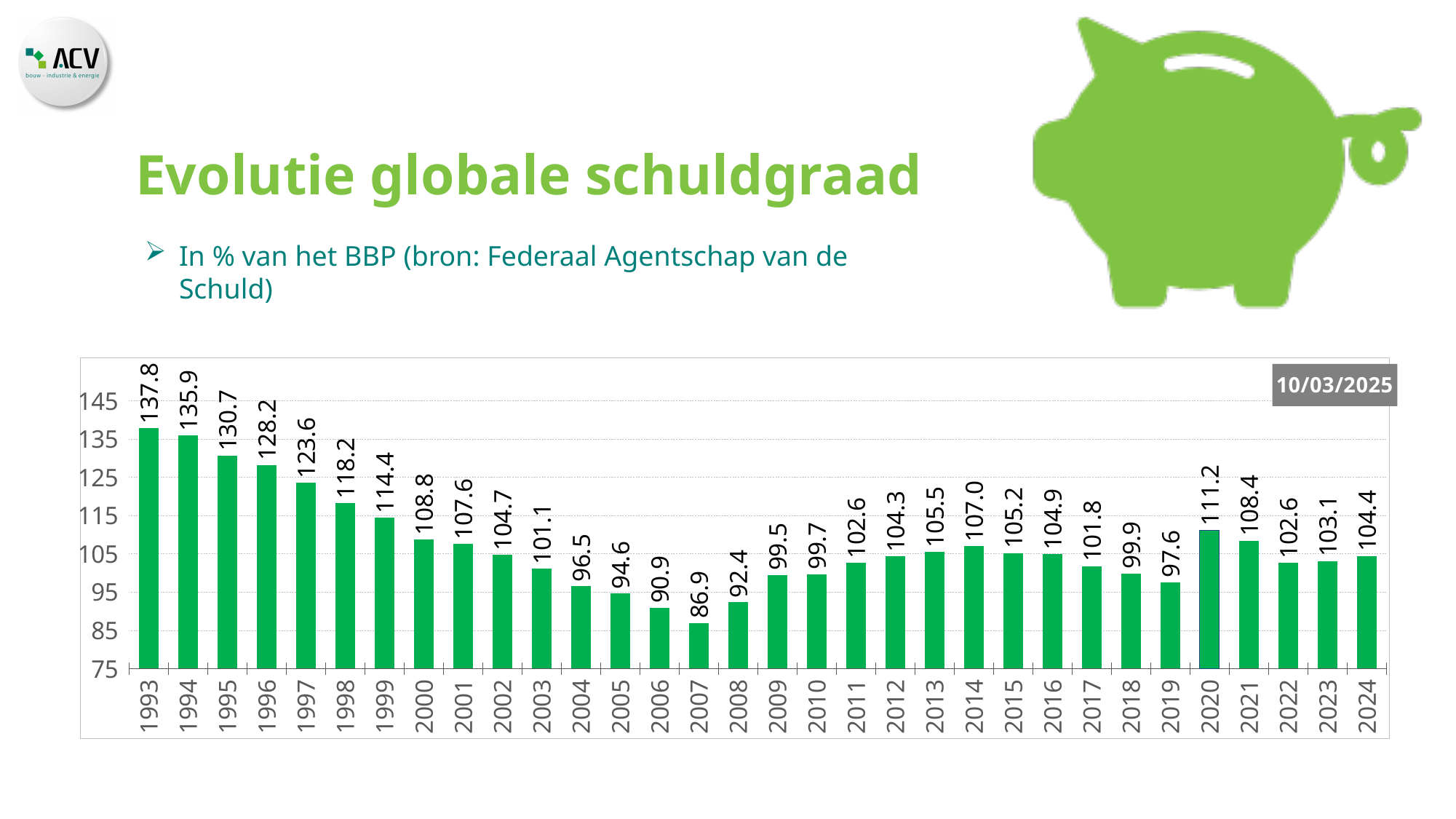
What is the difference between the values for 1993 and 2007? 50.9 What kind of chart is shown? bar chart What is the value for 2024? 104.4 What is the value for 2020? 111.2 Do the values rise or fall from 1993 to 2007? fall How many years are shown on the x axis? 32 Which year has the lowest value? 2007 What is the value for 1993? 137.8 Which is larger, the value for 2014 or the value for 2021? 2014 What is the value for 2007? 86.9 What is the title of the slide? Evolutie globale schuldgraad Which year has the highest value? 1993